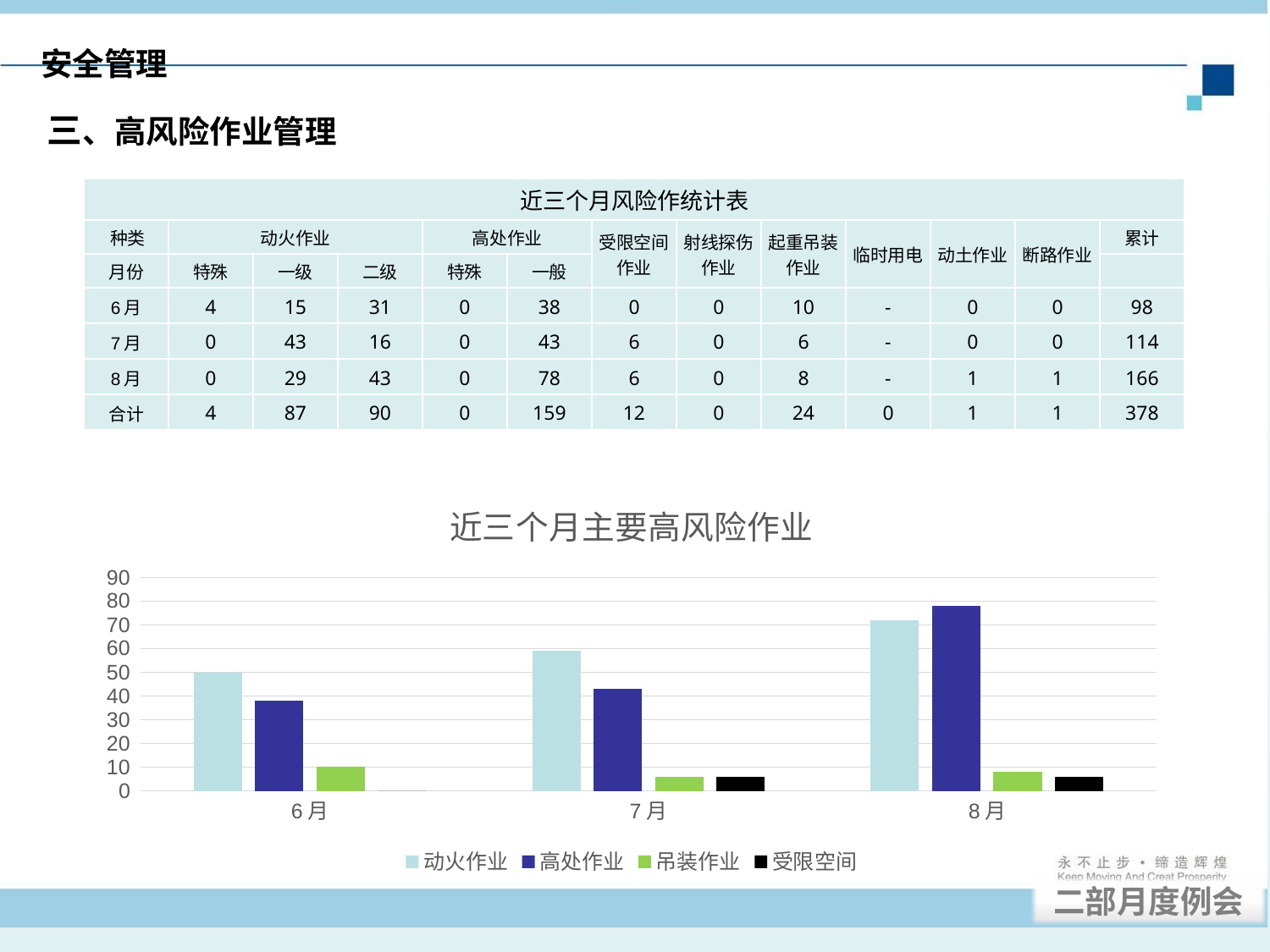
What is the value for 动火作业 in 6月 in the chart? 50 Does the 动火作业 series rise or fall from 6月 to 8月? rise What is the value for 吊装作业 in 6月 in the chart? 10 How many months are shown on the x axis of the chart? 3 Which month has the lowest 动火作业 bar in the chart? 6月 In 8月, which is larger in the chart: 动火作业 or 高处作业? 高处作业 Which month has the highest 高处作业 bar in the chart? 8月 What is the title of the chart? 近三个月主要高风险作业 How many series does the chart legend list? 4 What kind of chart is shown on the slide? bar chart Which series is shown in black in the chart legend? 受限空间 Is the value for 高处作业 in 7月 greater or less than 40? greater